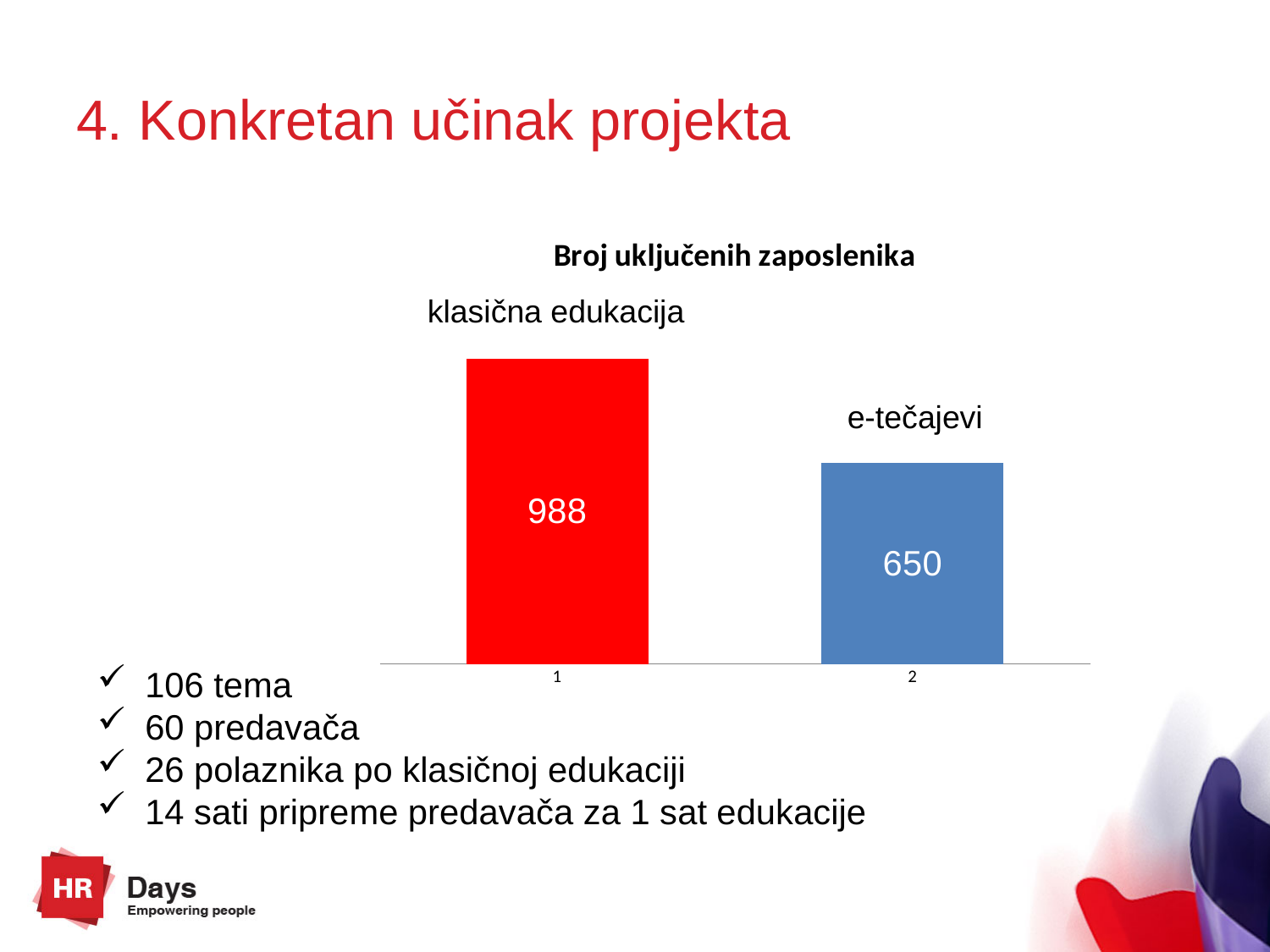
What is the difference between the values for klasična edukacija and e-tečajevi? 338 What is the value for e-tečajevi? 650 What kind of chart is shown on the slide? bar chart What is the value for klasična edukacija? 988 What is the title of the chart? Broj uključenih zaposlenika Which category has the highest value? klasična edukacija What is the total of the two bars in the chart? 1638 Which category has the lowest value? e-tečajevi Which is larger, the value for klasična edukacija or the value for e-tečajevi? klasična edukacija How many bars are plotted in the chart? 2 What colour is the bar for klasična edukacija? red